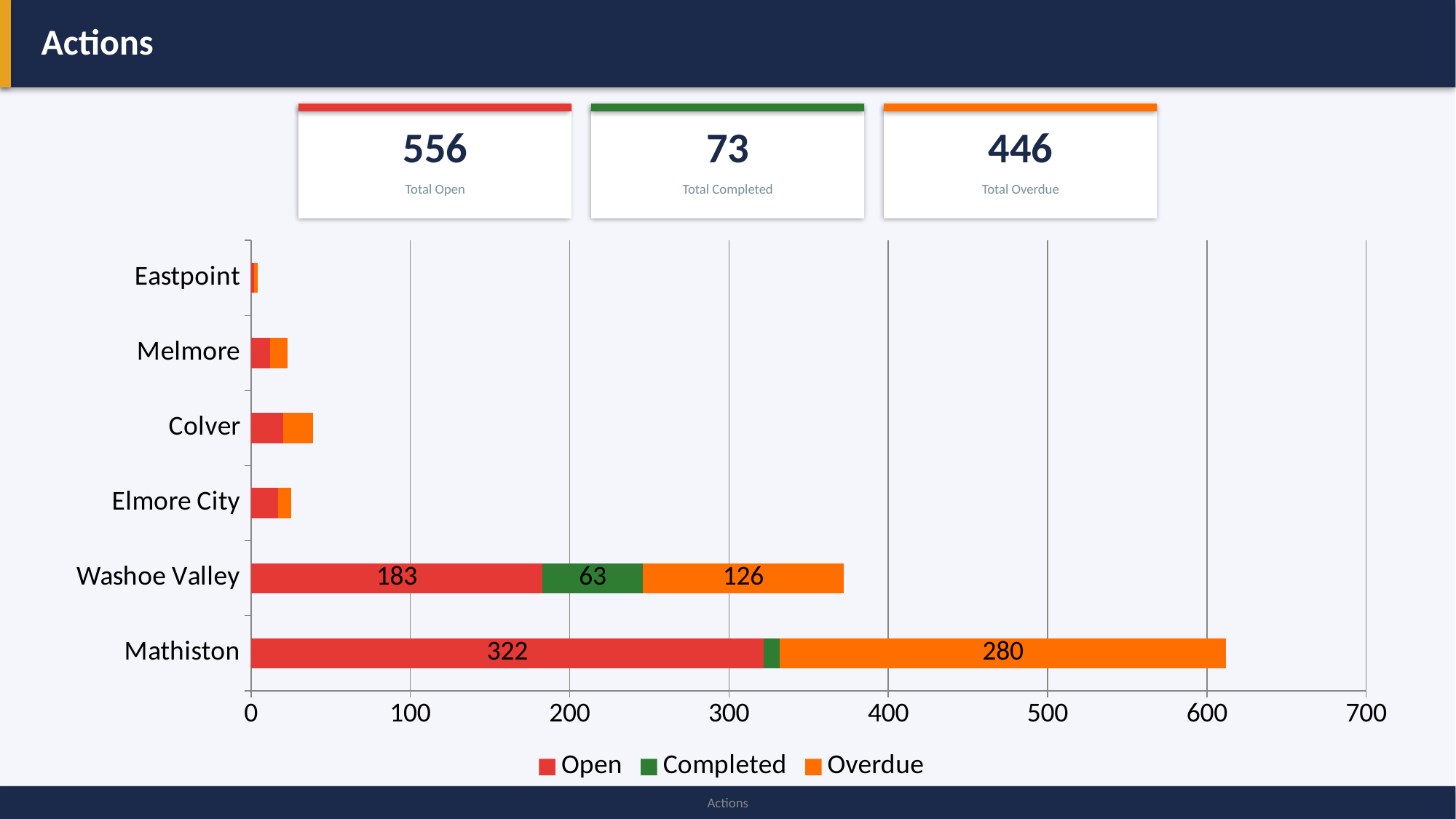
Which category has the longest stacked bar? Mathiston What is the Overdue value for Mathiston? 280 What is the Open value for Mathiston? 322 What is the total of the stacked bar for Washoe Valley? 372 What is the difference between the Overdue values for Mathiston and Washoe Valley? 154 Which category has the shortest stacked bar? Eastpoint What is the Completed value for Washoe Valley? 63 How much larger is the Open value for Mathiston than the Open value for Washoe Valley? 139 How many categories are shown on the chart? 6 What is the Open value for Washoe Valley? 183 How many series does the legend list? 3 Is the total length of the Mathiston bar greater or less than 600? greater